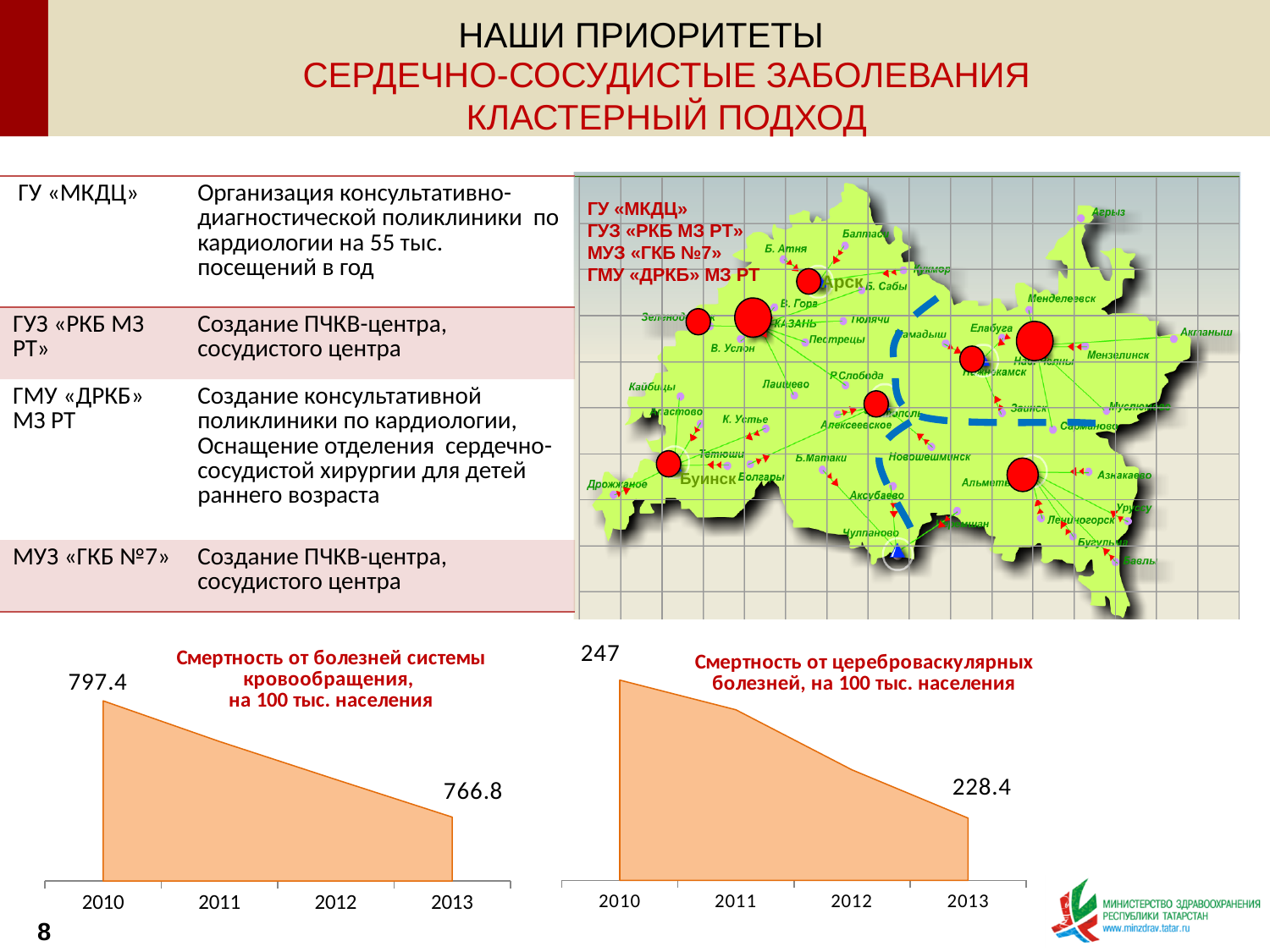
In the chart titled "Смертность от цереброваскулярных болезней, на 100 тыс. населения", which year has the lowest value? 2013 In the chart titled "Смертность от болезней системы кровообращения, на 100 тыс. населения", what is the value for 2013? 766.8 In the chart titled "Смертность от цереброваскулярных болезней, на 100 тыс. населения", what is the value for 2013? 228.4 In the chart titled "Смертность от болезней системы кровообращения, на 100 тыс. населения", what is the value for 2010? 797.4 In the chart titled "Смертность от цереброваскулярных болезней, на 100 тыс. населения", what is the value for 2010? 247 How many years are shown on the x axis of the chart titled "Смертность от цереброваскулярных болезней, на 100 тыс. населения"? 4 In the chart titled "Смертность от цереброваскулярных болезней, на 100 тыс. населения", do the values rise or fall along the x axis? fall In the chart titled "Смертность от болезней системы кровообращения, на 100 тыс. населения", which year has the higher value, 2010 or 2013? 2010 What kind of chart is the bottom-left chart on the slide? area chart In the chart titled "Смертность от цереброваскулярных болезней, на 100 тыс. населения", what is the difference between the 2010 and 2013 values? 18.6 In the chart titled "Смертность от болезней системы кровообращения, на 100 тыс. населения", by how much did the value decrease from 2010 to 2013? 30.6 In the chart titled "Смертность от болезней системы кровообращения, на 100 тыс. населения", do the values rise or fall from 2010 to 2013? fall